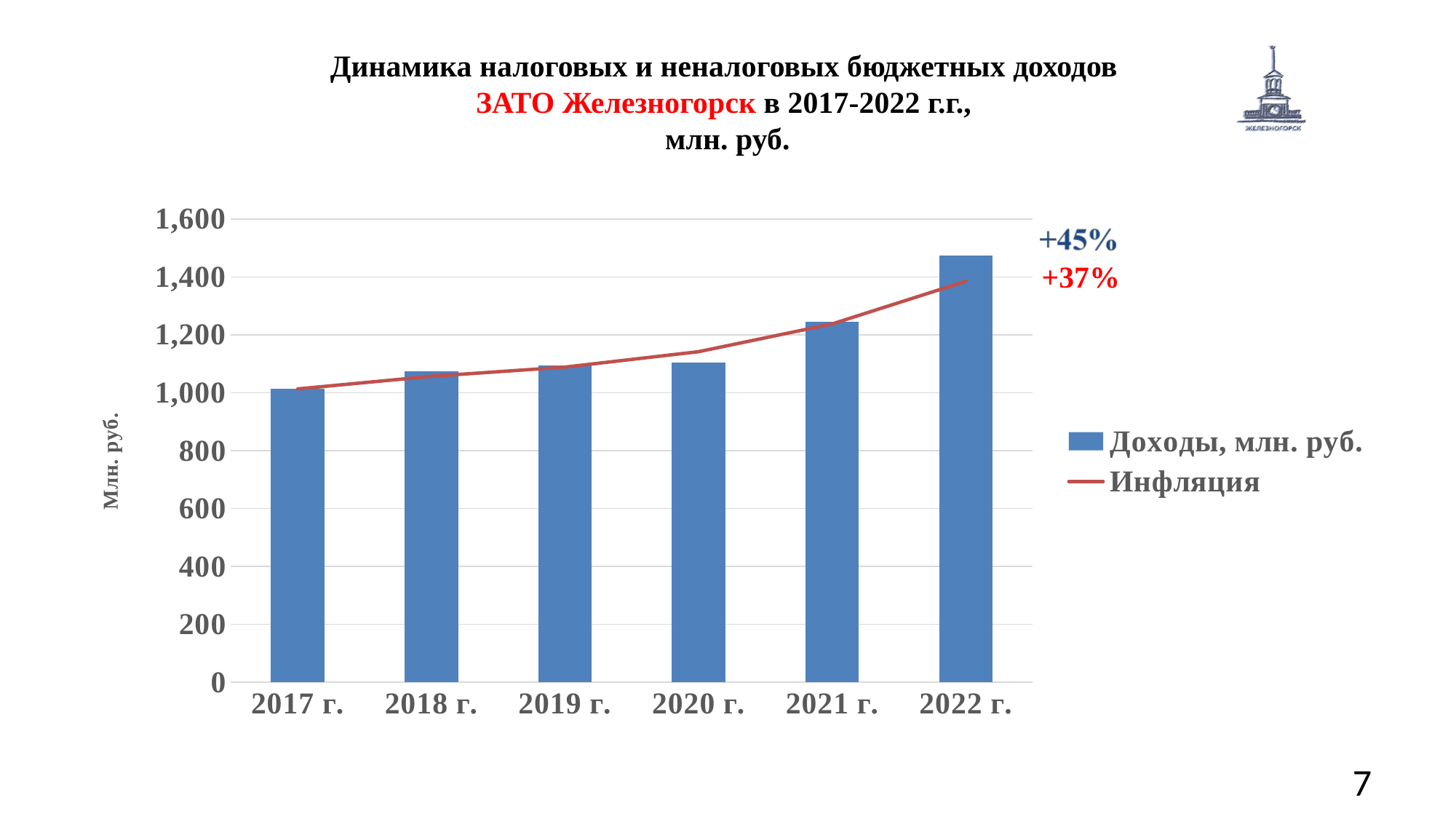
What type of chart is shown on the slide? A bar chart with a line overlay Which is larger, the Доходы value for 2021 г. or for 2020 г.? 2021 г. How many series does the legend list? 2 Is the value for Доходы in 2021 г. greater or less than 1,200? greater Is the value for Доходы in 2020 г. greater or less than 1,200? less How many years (categories) are shown on the x axis? 6 What percentage growth is annotated in blue next to the 2022 bar? +45% What are the two entries in the chart legend? Доходы, млн. руб. and Инфляция Is the value for Доходы in 2022 г. greater or less than 1,400? greater Which year has the lowest value for Доходы, млн. руб.? 2017 г. Do the Доходы values rise or fall from 2017 г. to 2022 г.? rise Which year has the highest value for Доходы, млн. руб.? 2022 г.